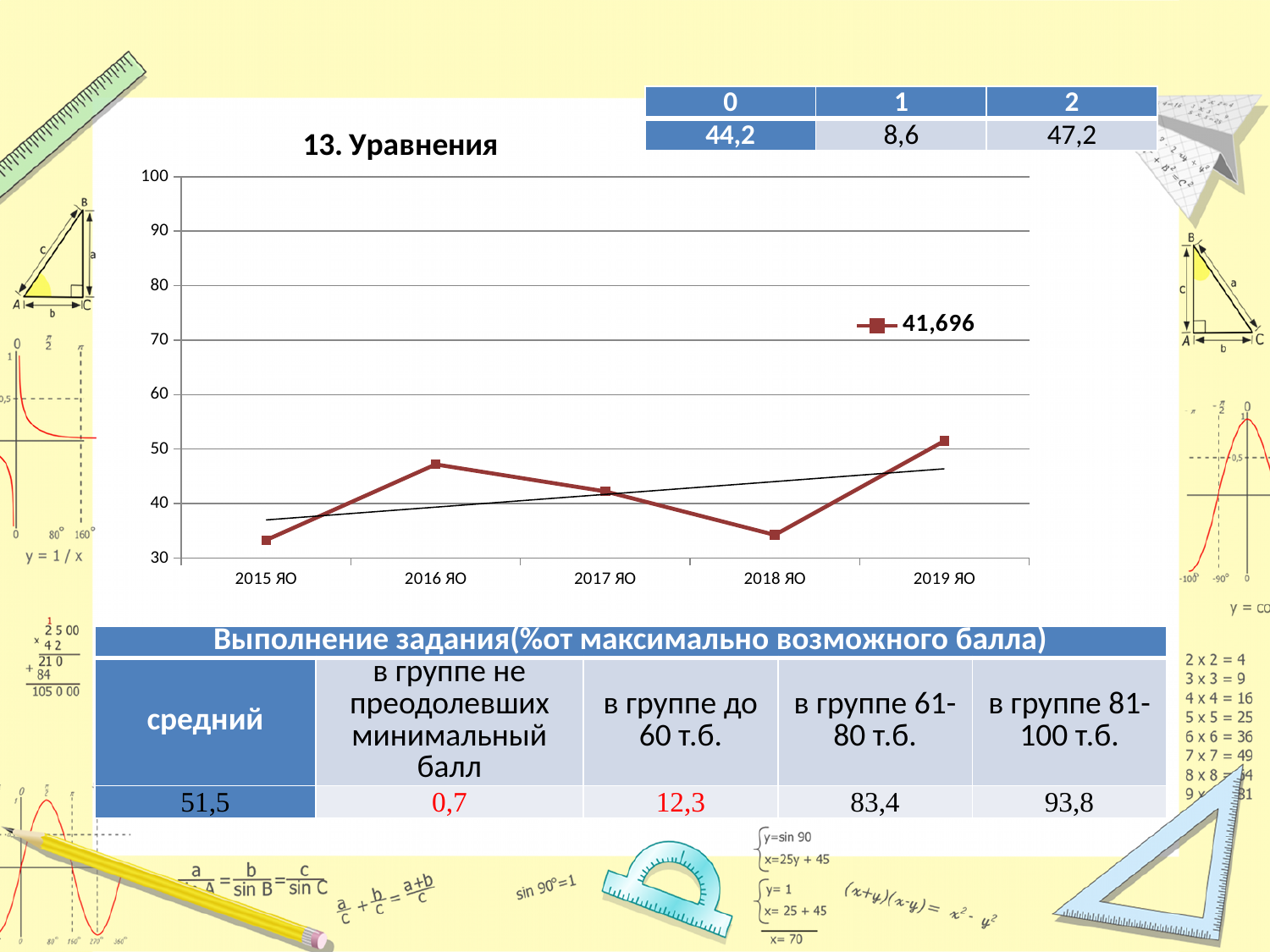
Does the value rise or fall from 2018 ЯО to 2019 ЯО? rise Which is larger, the value for 2018 ЯО or the value for 2019 ЯО? 2019 ЯО Is the value for 2019 ЯО greater or less than 40? greater Is the value for 2016 ЯО greater or less than 50? less Which year has the highest value on the chart? 2019 ЯО Which is larger, the value for 2016 ЯО or the value for 2017 ЯО? 2016 ЯО Is the value for 2018 ЯО greater or less than 40? less How many series does the chart legend list? 1 What label does the legend show for the plotted series? 41,696 How many data points are plotted along the x axis of the chart? 5 What is the title of the chart? 13. Уравнения What kind of chart is shown under the title "13. Уравнения"? line chart